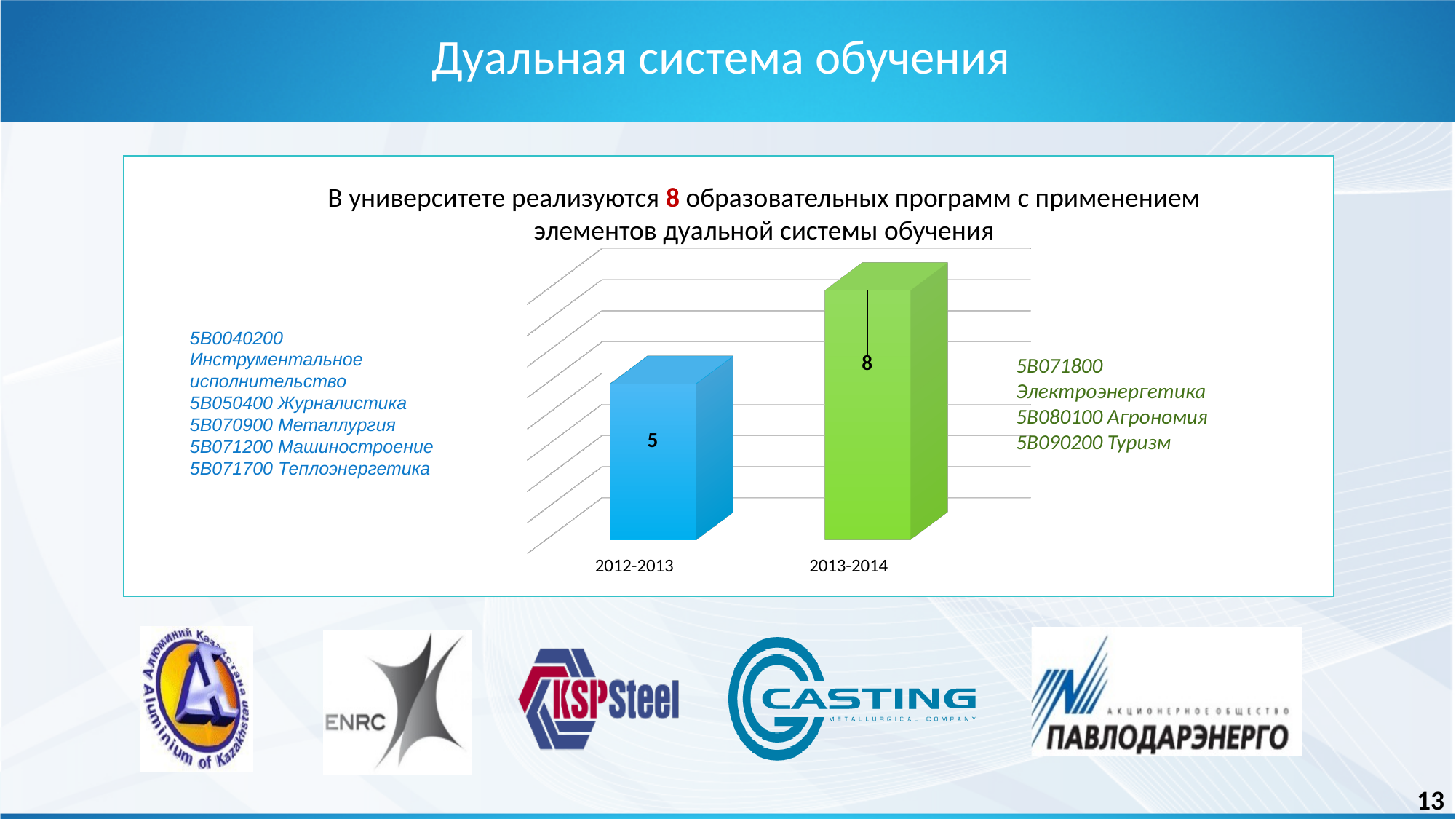
How many categories are shown on the x axis of the chart? 2 What colour is the bar for 2013-2014? green What colour is the bar for 2012-2013? blue What is the value for 2012-2013? 5 What kind of chart is shown on the slide? bar chart Do the values rise or fall from 2012-2013 to 2013-2014? rise Which category has the lowest value? 2012-2013 What is the value for 2013-2014? 8 What is the difference between the values for 2013-2014 and 2012-2013? 3 Which category has the highest value? 2013-2014 Which is larger, the value for 2012-2013 or the value for 2013-2014? 2013-2014